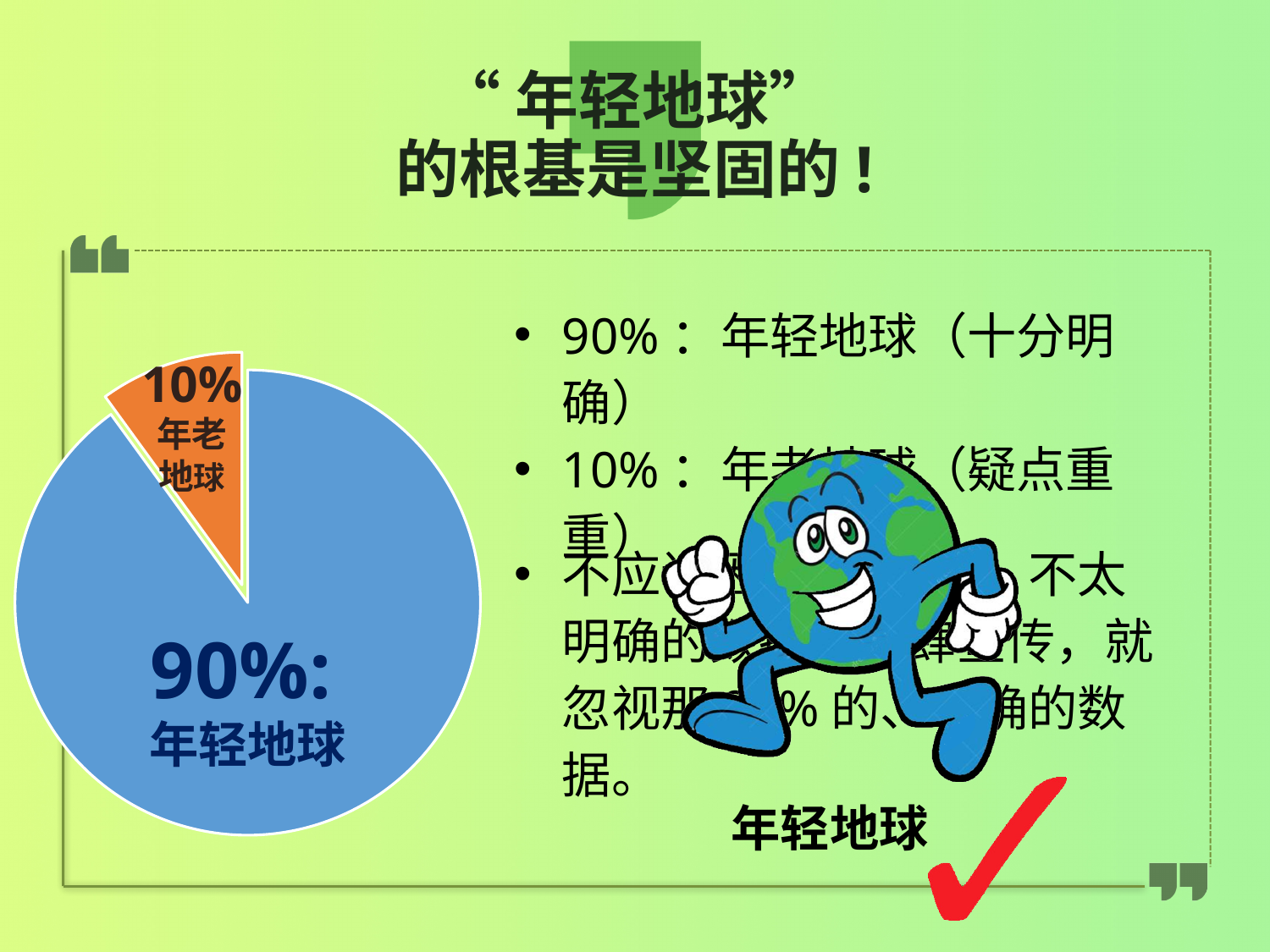
What share of the pie does 年轻地球 take? 90% What kind of chart is shown on the slide? pie chart How many slices does the pie chart have? 2 What is the difference in percentage points between the 年轻地球 slice and the 年老地球 slice? 80 Is the share for 年老地球 greater or less than 50%? less Which slice of the pie chart is the smallest? 年老地球 What colour is the 年轻地球 slice of the pie chart? blue Which is larger in the pie chart, 年轻地球 or 年老地球? 年轻地球 What colour is the 年老地球 slice of the pie chart? orange Which slice of the pie chart is the largest? 年轻地球 What is the total of the two slices shown in the pie chart? 100% What share of the pie does 年老地球 take? 10%